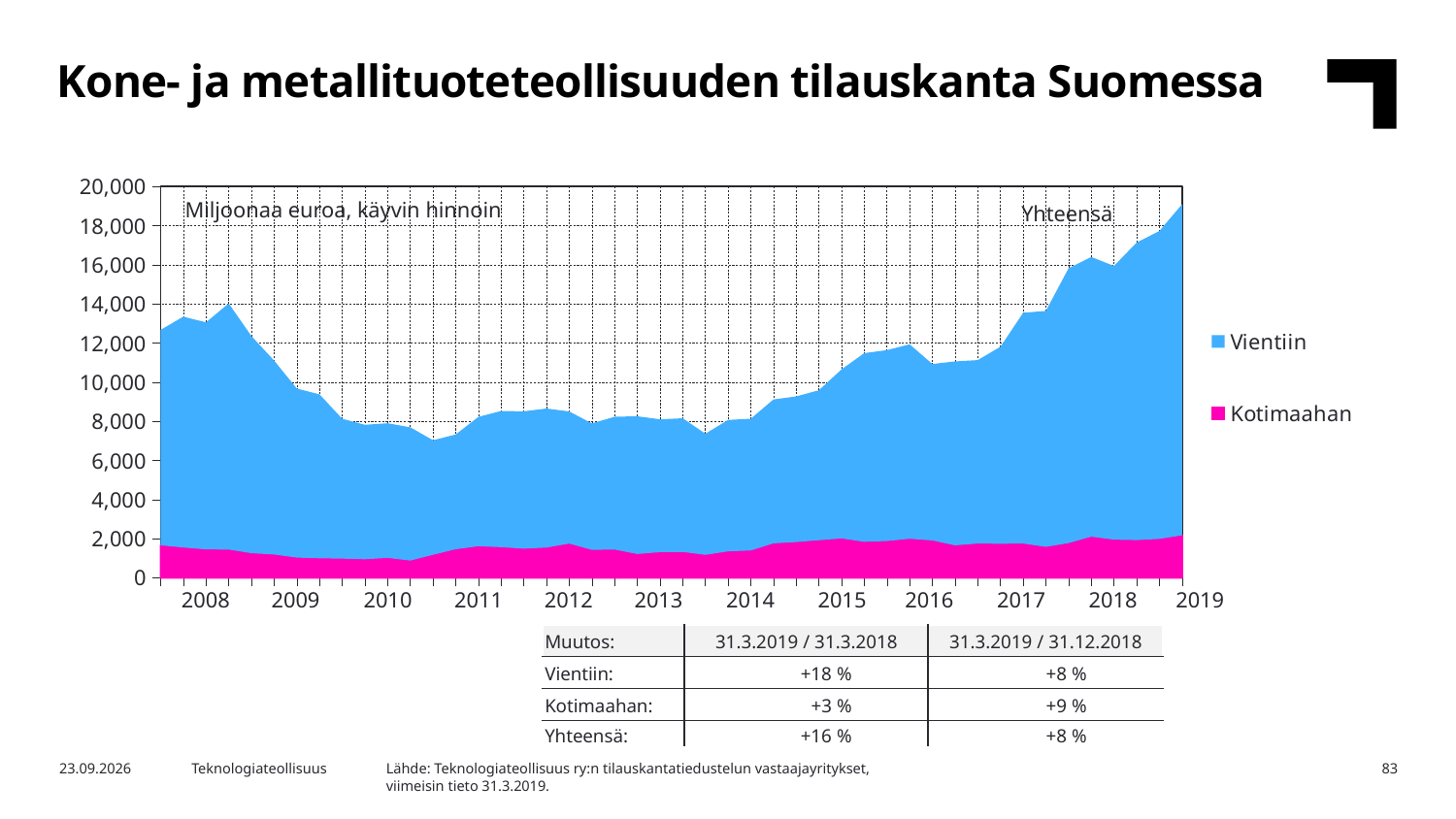
In which year does the total order backlog (Yhteensä) reach its highest level on the chart? 2019 Is the Kotimaahan value at any point on the chart greater or less than 4,000? less Does the total order backlog rise or fall between 2014 and 2019? Rise Is the total value (Yhteensä) at the start of 2010 greater or less than 10,000? less Which series is larger throughout the chart, Vientiin or Kotimaahan? Vientiin Is the total value (Yhteensä) at the start of 2019 greater or less than 18,000? greater Which two series are listed in the chart legend? Vientiin and Kotimaahan What is the title of the chart on the slide? Kone- ja metallituoteteollisuuden tilauskanta Suomessa What kind of chart is shown on the slide? Stacked area chart Does the total order backlog rise or fall between 2008 and 2010? Fall How many year labels are shown on the x axis of the chart? 12 How many series does the chart legend list? 2